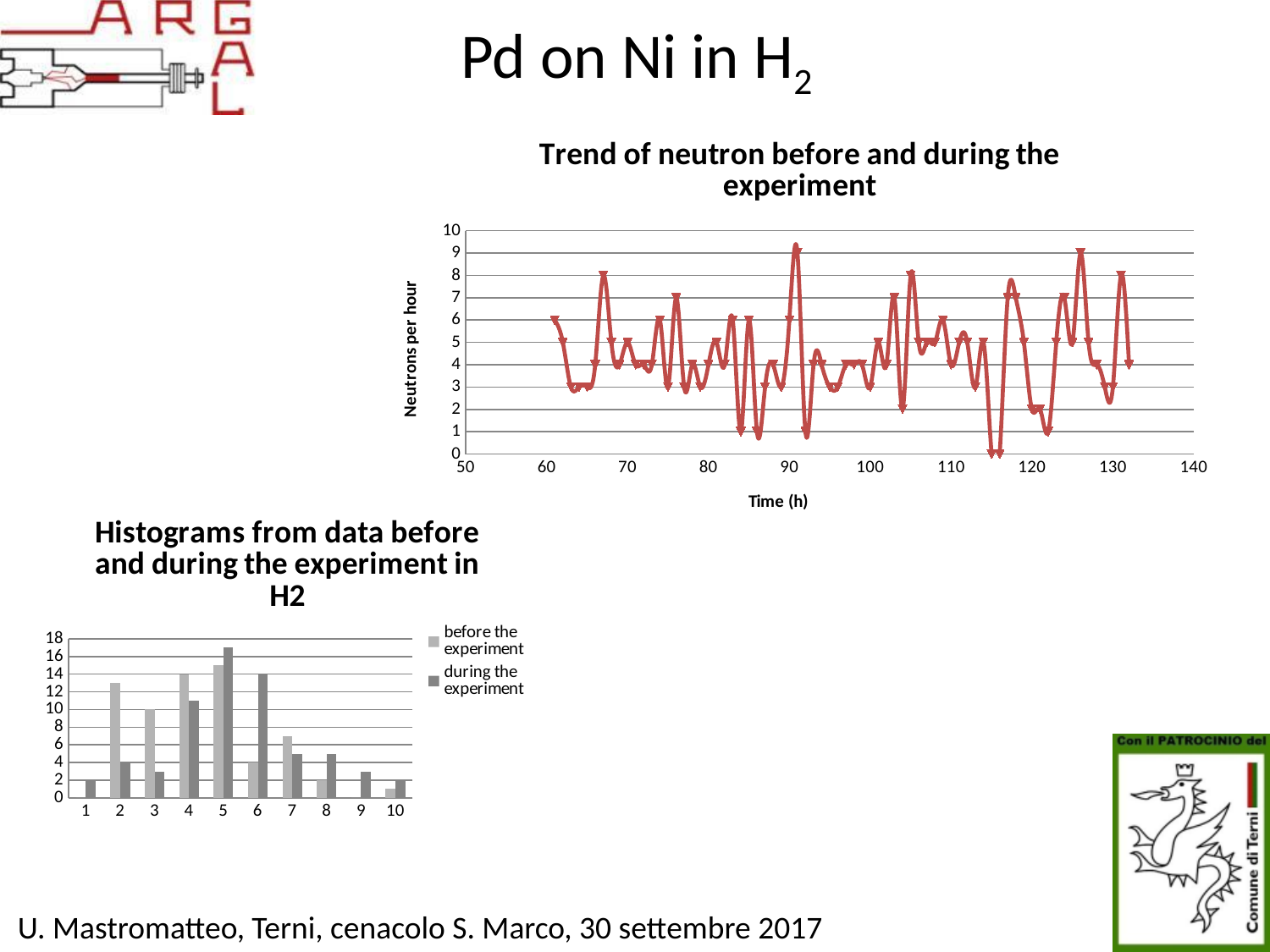
In the 'Histograms from data before and during the experiment in H2' chart, which category has the highest value for 'during the experiment'? 5 How many series does the legend of the 'Histograms from data before and during the experiment in H2' chart list? 2 What kind of chart is the 'Trend of neutron before and during the experiment' chart? line chart In the 'Histograms from data before and during the experiment in H2' chart, what is the value of 'during the experiment' for category 6? 14 In the 'Trend of neutron before and during the experiment' chart, what is the label of the y axis? Neutrons per hour How many categories are on the x axis of the 'Histograms from data before and during the experiment in H2' chart? 10 In the 'Histograms from data before and during the experiment in H2' chart, what is the value of 'before the experiment' for category 6? 4 In the 'Histograms from data before and during the experiment in H2' chart, is the 'before the experiment' value for category 2 greater or less than 12? greater What kind of chart is the 'Histograms from data before and during the experiment in H2' chart? bar chart In the 'Trend of neutron before and during the experiment' chart, is the peak value near 90 h greater or less than 8? greater In the 'Trend of neutron before and during the experiment' chart, what is the label of the x axis? Time (h) In the 'Histograms from data before and during the experiment in H2' chart, which is larger for category 4: 'before the experiment' or 'during the experiment'? before the experiment